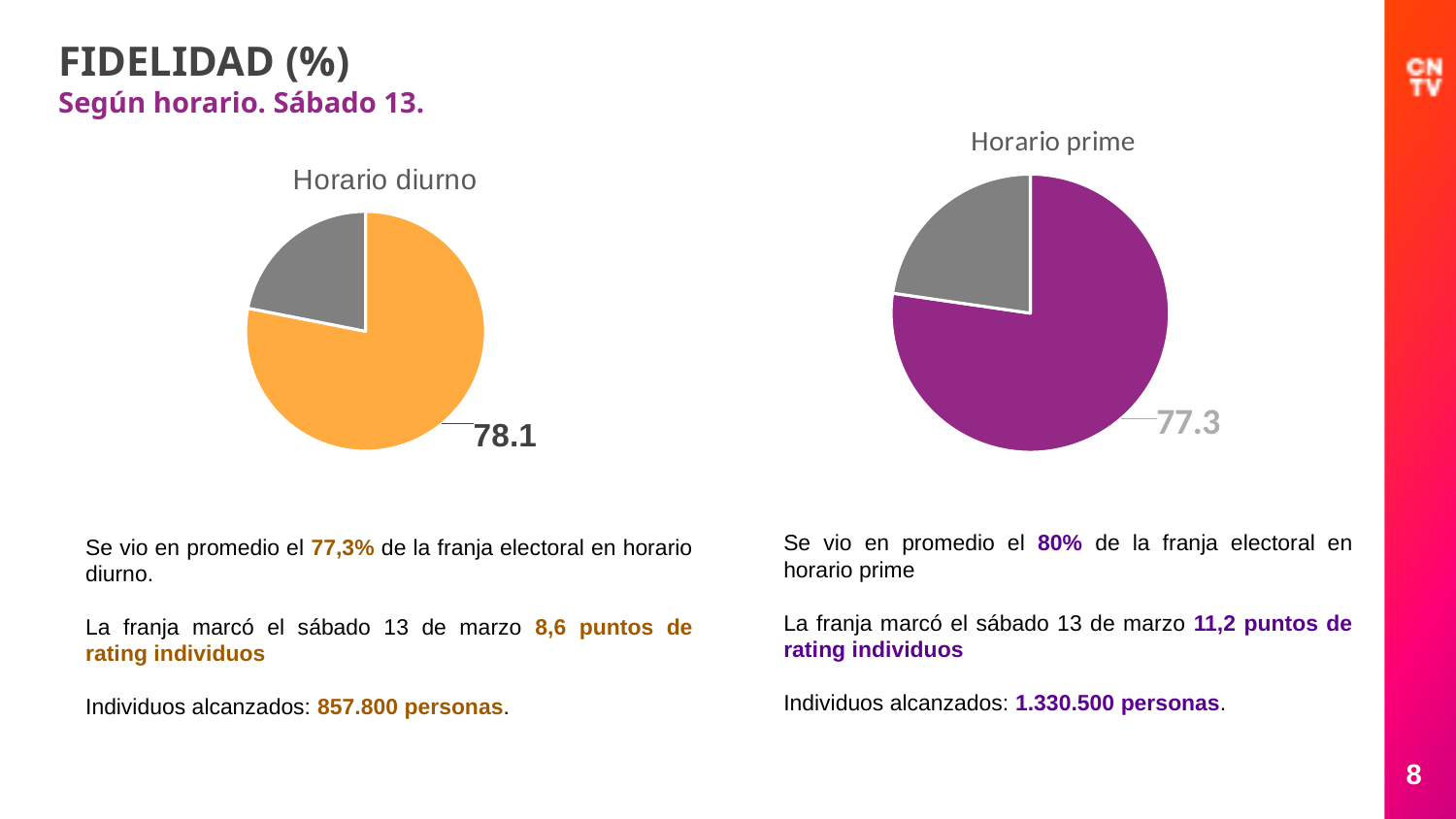
In the Horario prime pie chart, which slice is larger, the purple one or the grey one? The purple one In the Horario diurno pie chart, what value is printed on the orange slice? 78.1 What colour is the largest slice in the Horario prime pie chart? Purple In the Horario diurno pie chart, which slice is larger, the orange one or the grey one? The orange one Which is larger: the labelled value in the Horario diurno chart or the labelled value in the Horario prime chart? Horario diurno How many slices does the Horario diurno pie chart have? 2 What is the title of the pie chart on the left side of the slide? Horario diurno What kind of chart is the Horario diurno chart? Pie chart How many slices does the Horario prime pie chart have? 2 In the Horario prime pie chart, what value is printed on the purple slice? 77.3 What is the difference between the labelled value in the Horario diurno chart (78.1) and the labelled value in the Horario prime chart (77.3)? 0.8 What kind of chart is the Horario prime chart? Pie chart